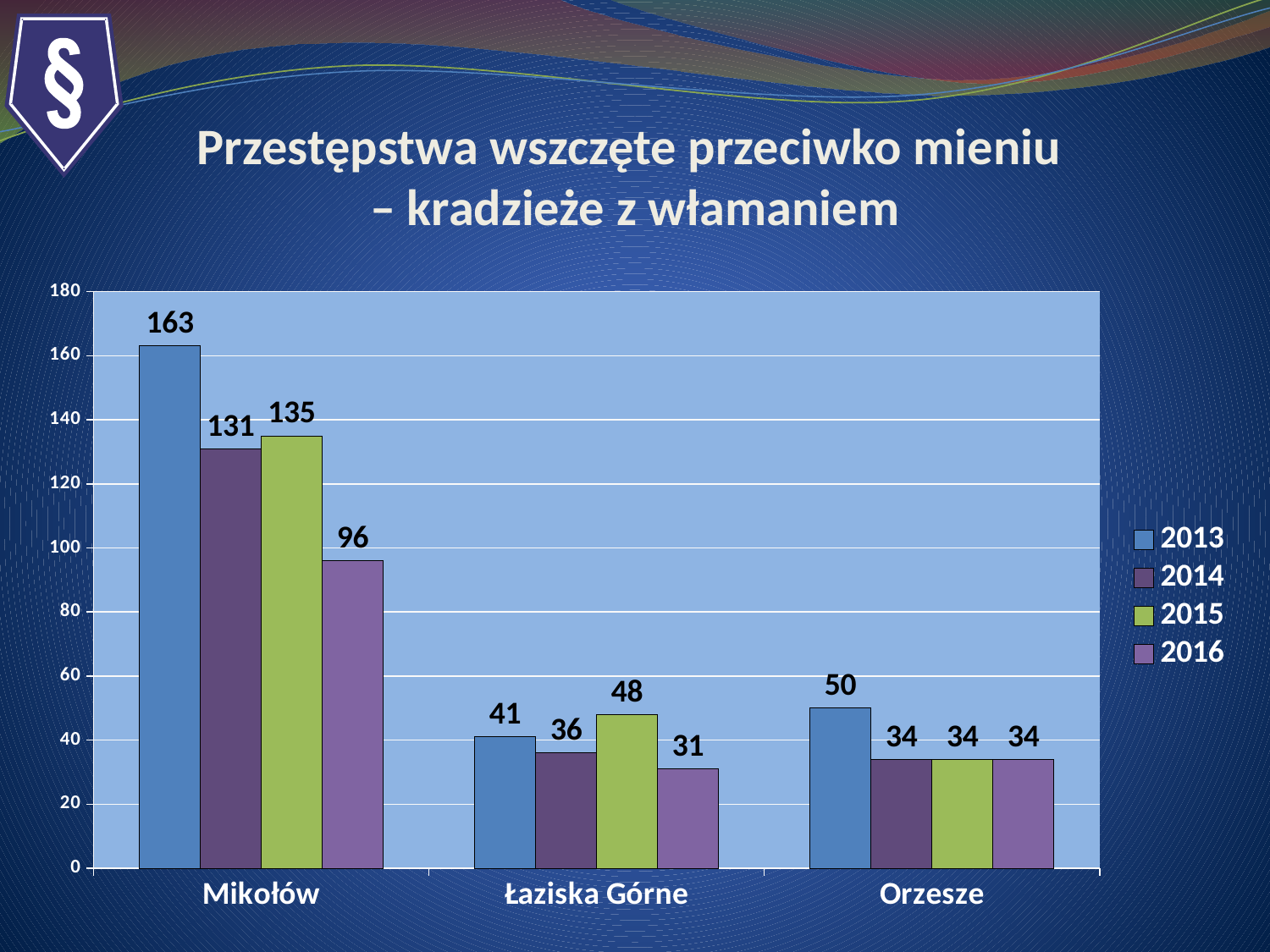
Which category has the highest value in 2016? Mikołów What is the value for Łaziska Górne in 2015? 48 How many series does the legend list? 4 How many categories are shown on the x axis? 3 Is the value for Mikołów in 2014 greater or less than 120? greater What is the difference between the 2013 and 2016 values for Mikołów? 67 What is the value for Mikołów in 2013? 163 What is the value for Orzesze in 2016? 34 Which is larger: the 2015 value for Łaziska Górne or the 2015 value for Orzesze? Łaziska Górne What kind of chart is shown on the slide? bar chart Which category has the lowest value in 2014? Orzesze Which year is shown in green in the legend? 2015